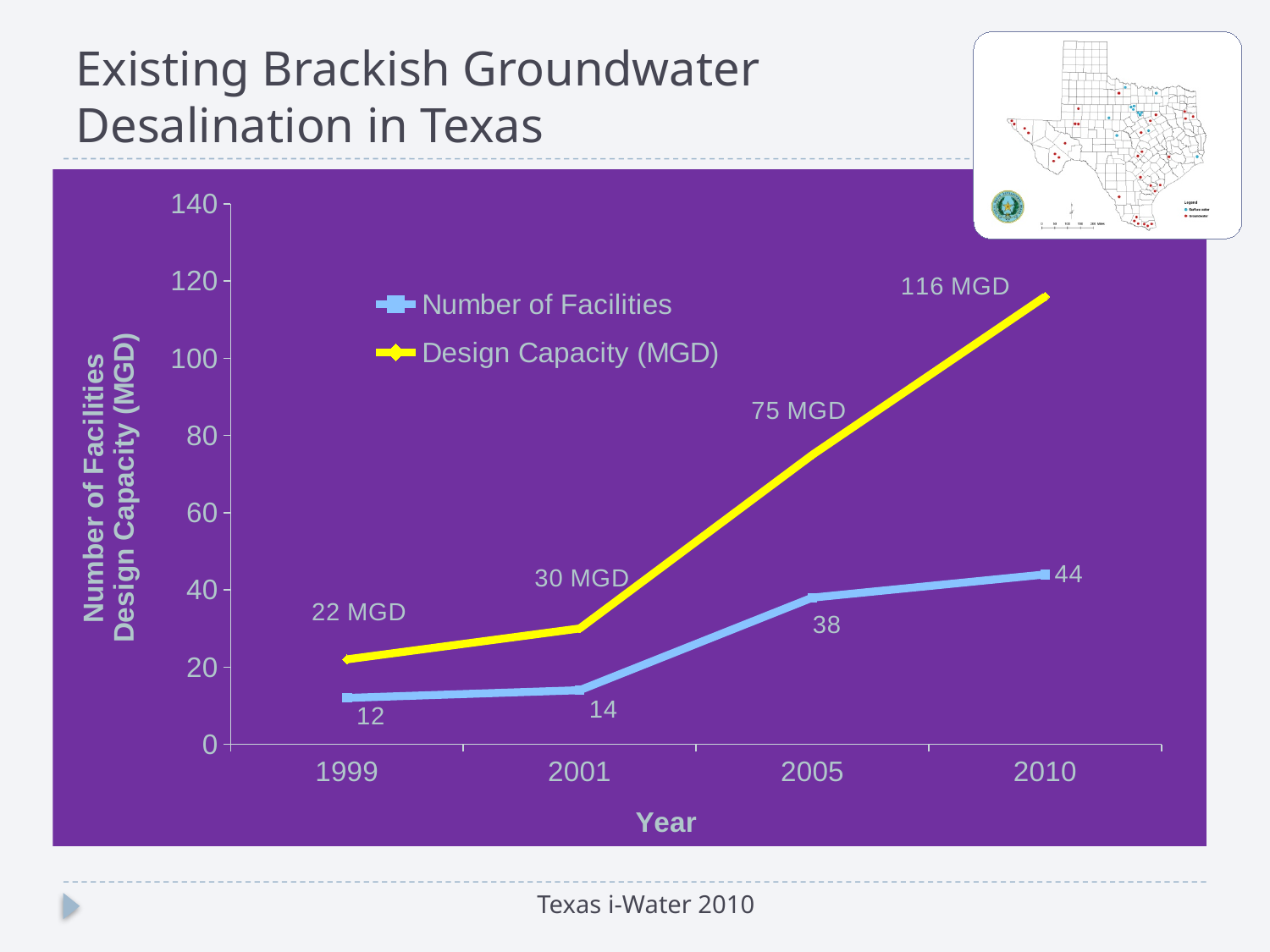
How many years are plotted on the x axis? 4 Which was larger in 2001: the Design Capacity (MGD) or the Number of Facilities? Design Capacity (MGD) How many series does the legend list? 2 In which year was the Design Capacity (MGD) highest? 2010 What was the Design Capacity (MGD) in 2005? 75 MGD Does the Design Capacity (MGD) rise or fall from 1999 to 2010? Rise What was the Number of Facilities in 2010? 44 What was the Number of Facilities in 2001? 14 By how much did the Design Capacity (MGD) increase from 2005 to 2010? 41 MGD In which year was the Number of Facilities lowest? 1999 What is the difference in the Number of Facilities between 2010 and 1999? 32 What kind of chart is shown on the slide? Line chart